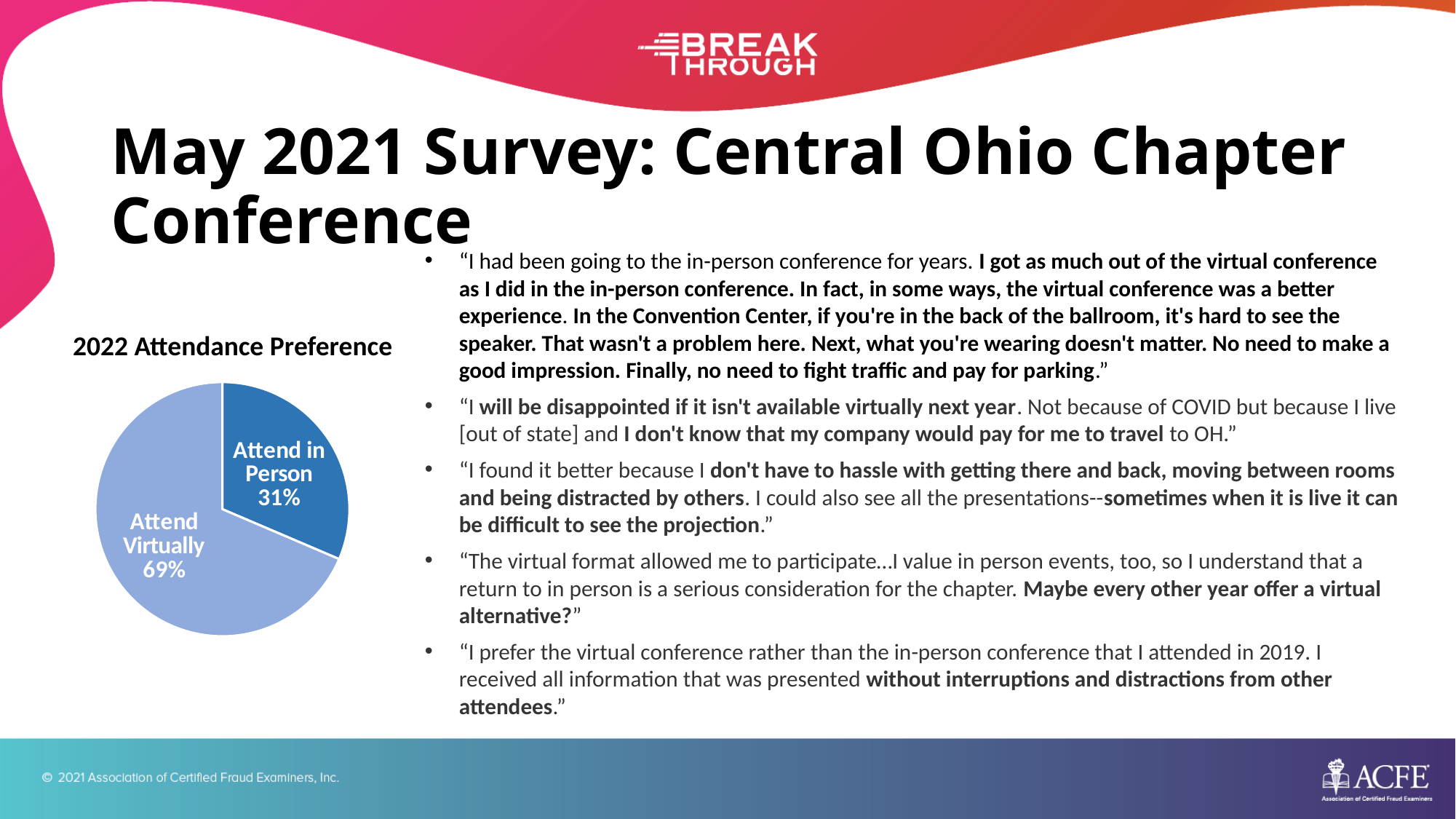
Which is larger, the share for Attend in Person or the share for Attend Virtually? Attend Virtually What is the title of the chart? 2022 Attendance Preference Which attendance preference has the largest share? Attend Virtually Which attendance preference has the smallest share? Attend in Person What share of respondents prefer to attend virtually? 69% Is the share for Attend in Person greater or less than 50%? less What share of respondents prefer to attend in person? 31% What kind of chart is shown on the slide? Pie chart How many slices does the pie chart have? 2 What is the difference in percentage points between Attend Virtually and Attend in Person? 38 What colour is the Attend in Person slice? Dark blue